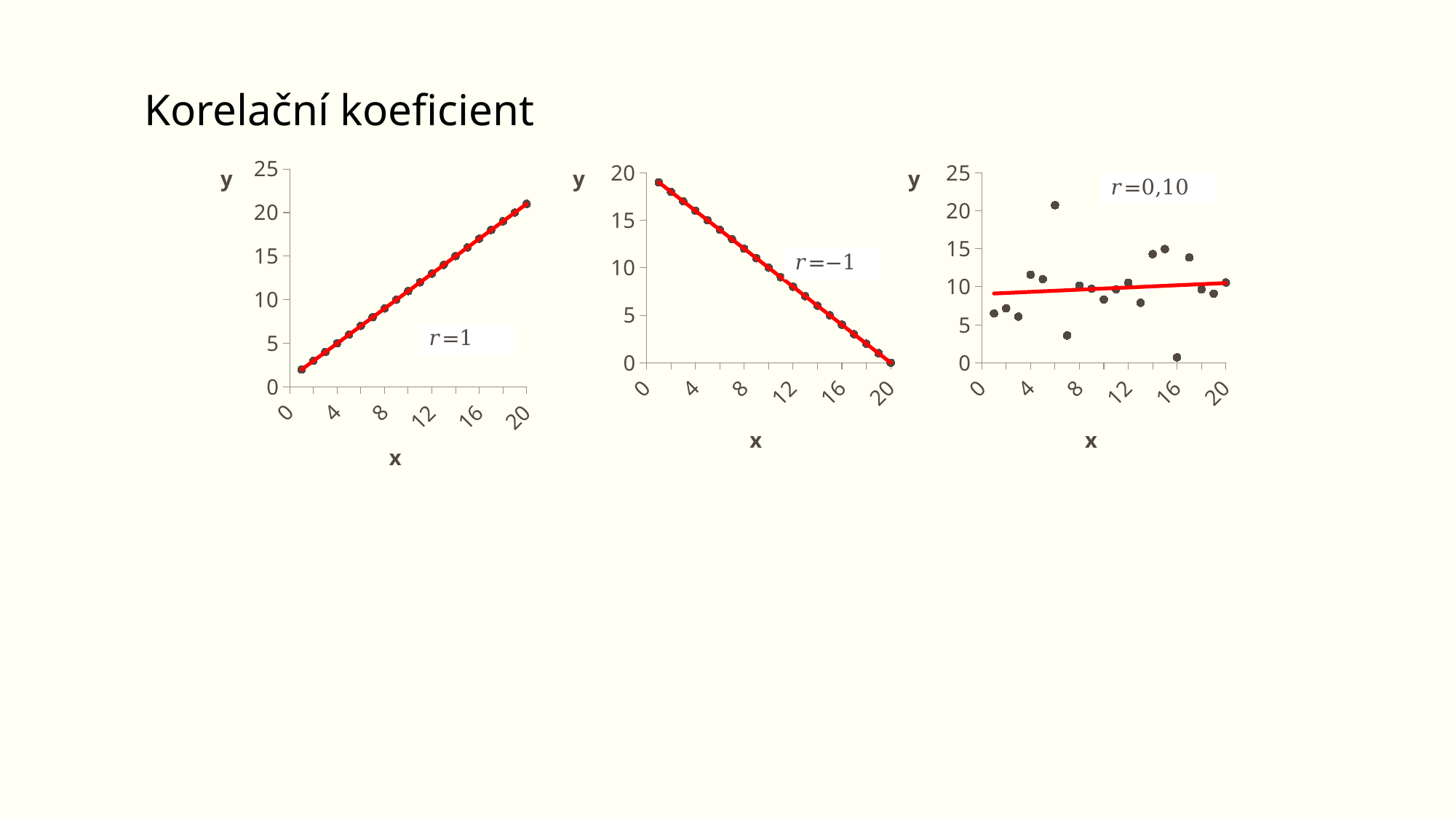
In the right chart (r=0,10), at which x value is the highest y value plotted? 6 In the right chart (r=0,10), at which x value is the lowest y value plotted? 16 What correlation coefficient is printed on the middle chart? r=−1 In the left chart (r=1), is the y value at x=20 greater or less than 20? greater What kind of chart is the left chart on the slide? scatter chart In the middle chart (r=−1), is the y value at x=1 greater or less than 15? greater In the left chart (r=1), do the y values rise or fall as x increases? rise In the right chart (r=0,10), is the y value at x=16 greater or less than 5? less In the middle chart (r=−1), do the y values rise or fall as x increases? fall What correlation coefficient is printed on the right chart? r=0,10